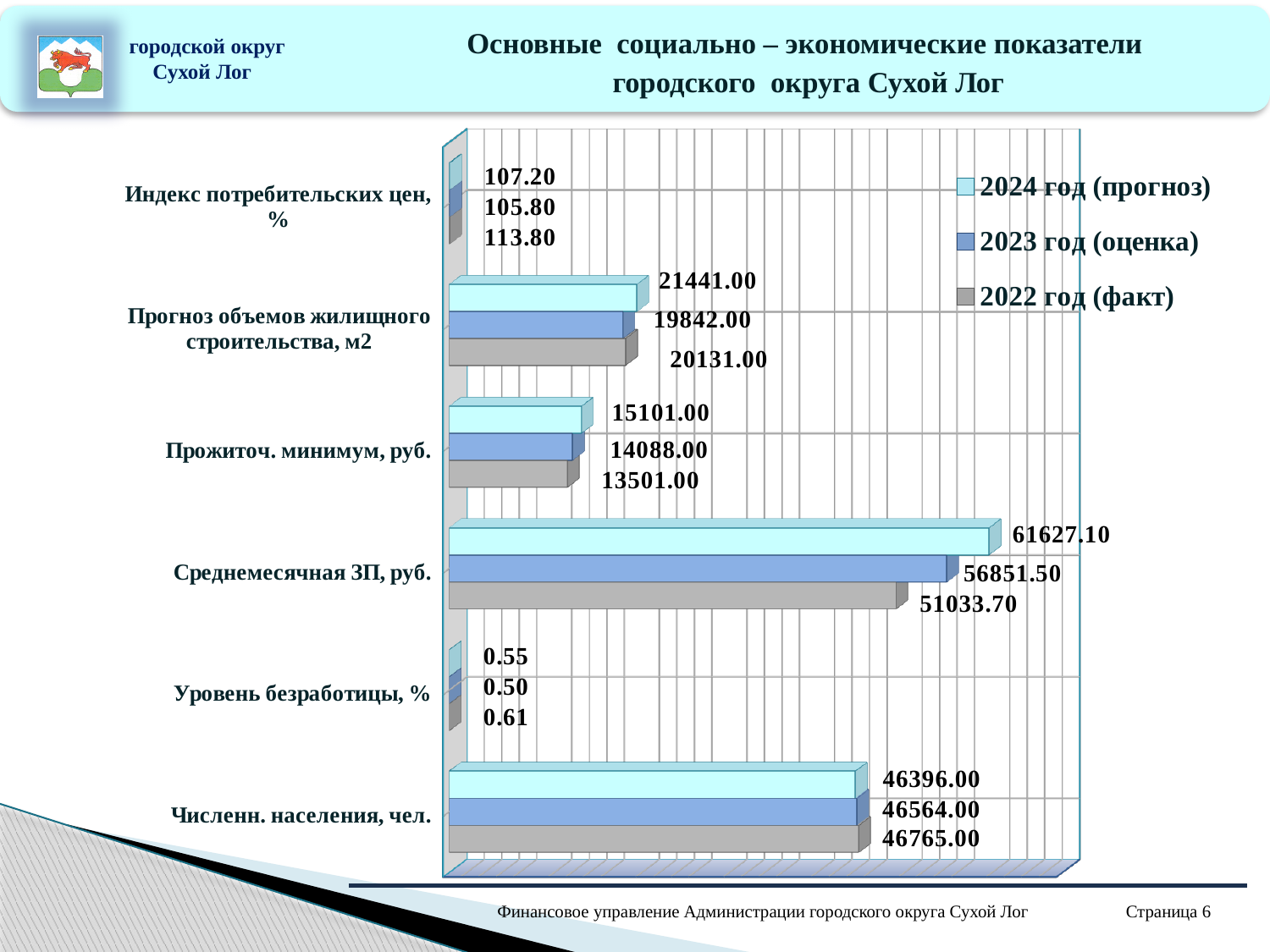
What is the difference between the 2024 год (прогноз) and 2022 год (факт) values for Среднемесячная ЗП, руб.? 10593.40 Which series has the highest value for Прогноз объемов жилищного строительства, м2? 2024 год (прогноз) Which series has the lowest value for Численн. населения, чел.? 2024 год (прогноз) How many categories are shown on the chart? 6 What is the value for Прожиточ. минимум, руб. in the 2022 год (факт) series? 13501.00 How many series does the legend list? 3 What is the value for Численн. населения, чел. in the 2022 год (факт) series? 46765.00 What is the value for Индекс потребительских цен, % in the 2024 год (прогноз) series? 107.20 What is the value for Среднемесячная ЗП, руб. in the 2024 год (прогноз) series? 61627.10 What kind of chart is shown on the slide? Bar chart Which is larger for Уровень безработицы, %: the 2022 год (факт) value or the 2024 год (прогноз) value? 2022 год (факт) What is the value for Уровень безработицы, % in the 2023 год (оценка) series? 0.50